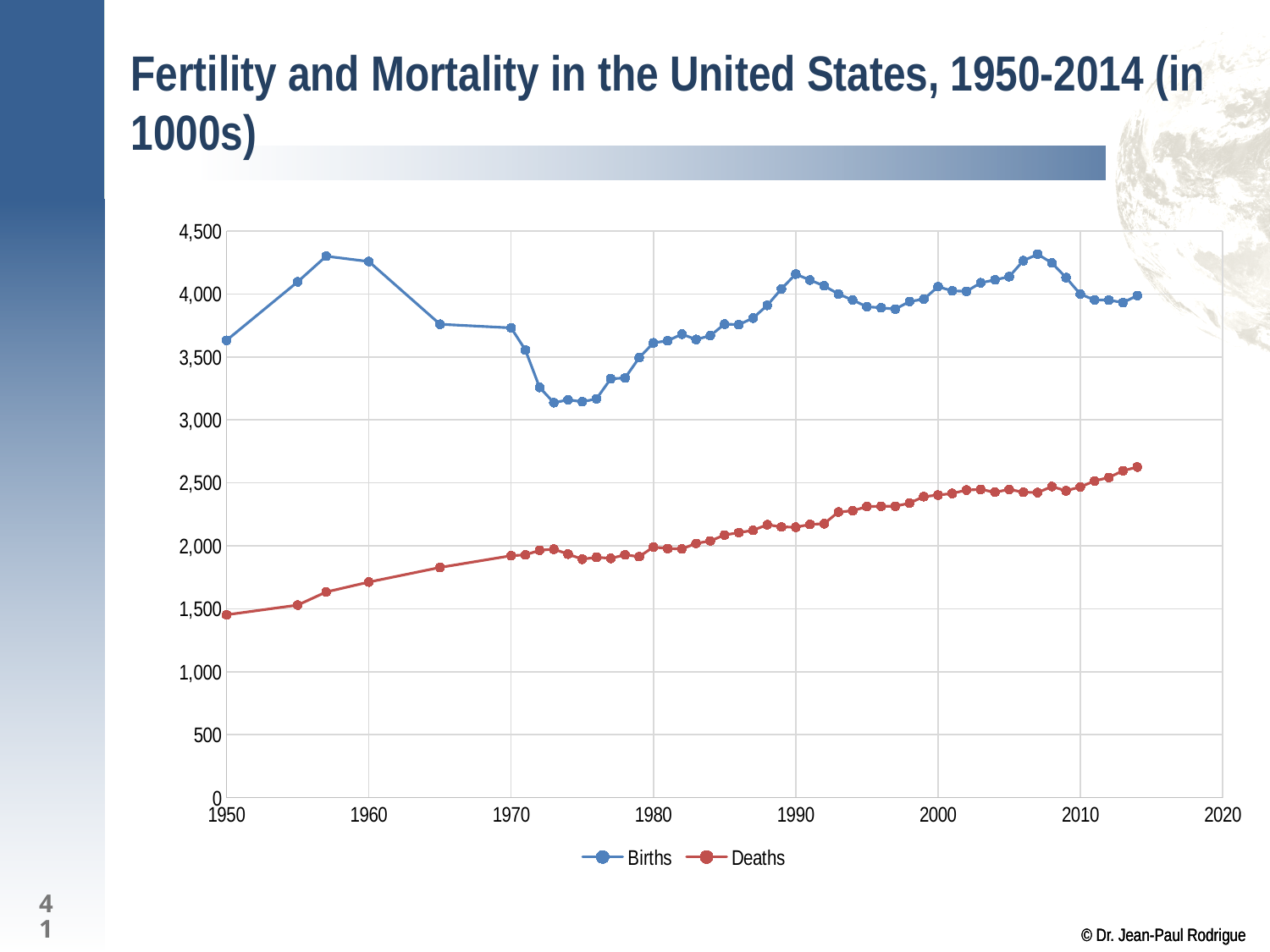
Is the value for Births in 1975 greater or less than 3,500? less Is the value for Deaths in 2014 greater or less than 2,500? greater Is the value for Deaths in 1970 greater or less than 2,500? less What kind of chart is shown on the slide? line chart What are the two series named in the legend? Births and Deaths What is the title of the chart on the slide? Fertility and Mortality in the United States, 1950-2014 (in 1000s) Which series has the higher values throughout the chart, Births or Deaths? Births How many series does the legend list? 2 Do the values for Deaths generally rise or fall from 1950 to 2014? rise